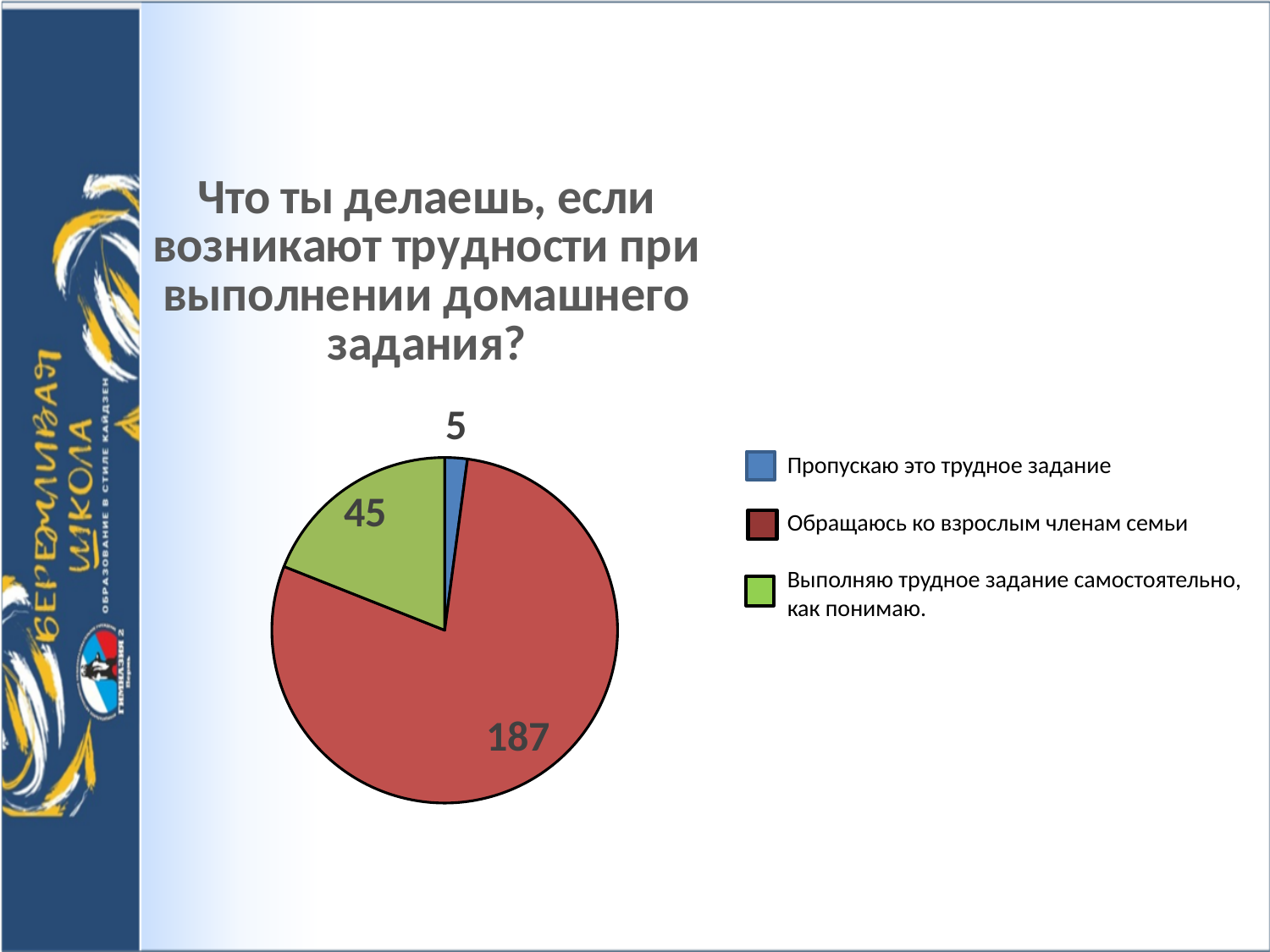
Which is larger: the value for "Выполняю трудное задание самостоятельно, как понимаю." or the value for "Пропускаю это трудное задание"? Выполняю трудное задание самостоятельно, как понимаю. What kind of chart is shown on the slide? pie chart What is the value for "Пропускаю это трудное задание"? 5 What is the difference between the values for "Обращаюсь ко взрослым членам семьи" and "Выполняю трудное задание самостоятельно, как понимаю."? 142 What colour is the slice for "Обращаюсь ко взрослым членам семьи"? red How many entries does the legend of the pie chart list? 3 Which category has the smallest slice of the pie? Пропускаю это трудное задание How many slices does the pie chart have? 3 What is the total of all the values shown in the pie chart? 237 What is the value for "Обращаюсь ко взрослым членам семьи"? 187 What is the value for "Выполняю трудное задание самостоятельно, как понимаю."? 45 Which category has the largest slice of the pie? Обращаюсь ко взрослым членам семьи